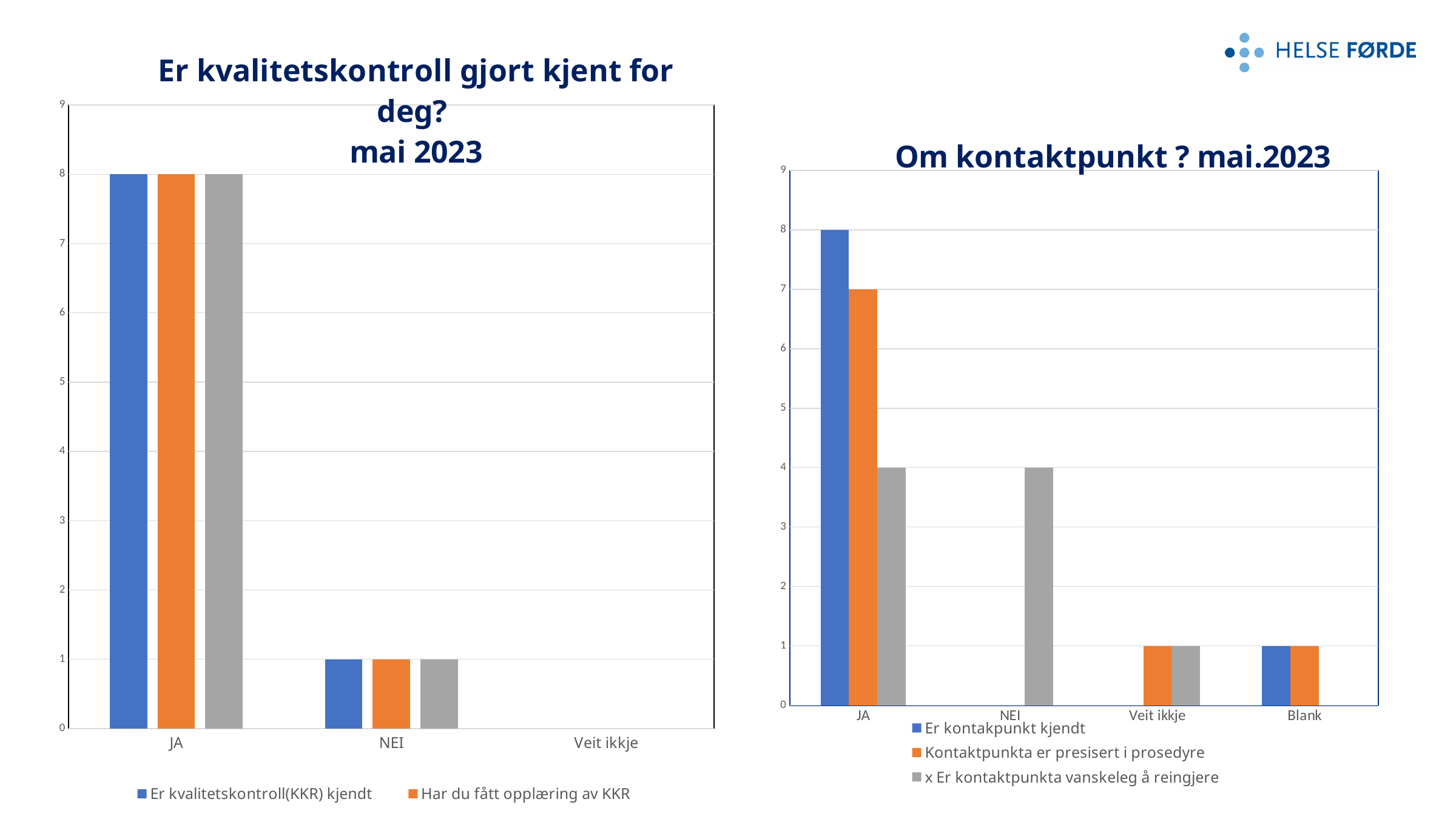
In the chart titled "Om kontaktpunkt ? mai.2023", what is the difference between the JA values of "Er kontakpunkt kjendt" and "Kontaktpunkta er presisert i prosedyre"? 1 In the chart titled "Om kontaktpunkt ? mai.2023", how many categories are shown on the x axis? 4 In the chart titled "Er kvalitetskontroll gjort kjent for deg? mai 2023", how many series does the legend list? 2 In the chart titled "Om kontaktpunkt ? mai.2023", what is the value of "x Er kontaktpunkta vanskeleg å reingjere" for NEI? 4 In the chart titled "Om kontaktpunkt ? mai.2023", what is the value of "Kontaktpunkta er presisert i prosedyre" for JA? 7 What kind of chart is the one titled "Er kvalitetskontroll gjort kjent for deg? mai 2023"? Bar chart In the chart titled "Er kvalitetskontroll gjort kjent for deg? mai 2023", what is the value of "Er kvalitetskontroll(KKR) kjendt" for JA? 8 In the chart titled "Er kvalitetskontroll gjort kjent for deg? mai 2023", what is the value of "Har du fått opplæring av KKR" for NEI? 1 In the chart titled "Om kontaktpunkt ? mai.2023", which category has the highest value for "Er kontakpunkt kjendt"? JA In the chart titled "Om kontaktpunkt ? mai.2023", what is the value of "Er kontakpunkt kjendt" for JA? 8 In the chart titled "Om kontaktpunkt ? mai.2023", how many series does the legend list? 3 In the chart titled "Er kvalitetskontroll gjort kjent for deg? mai 2023", which is larger for "Er kvalitetskontroll(KKR) kjendt": JA or NEI? JA